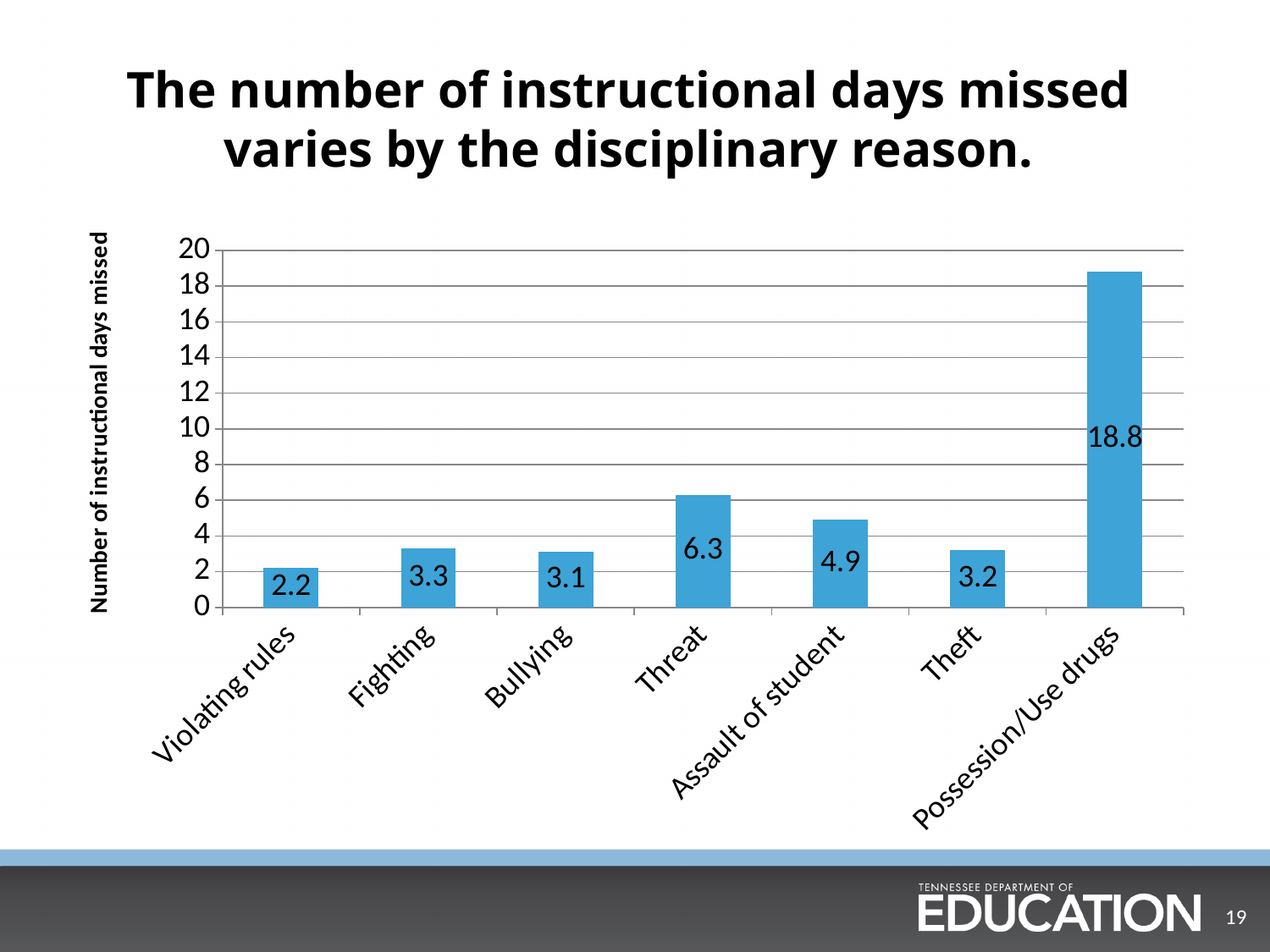
What kind of chart is shown on the slide? Bar chart Which disciplinary reason has the lowest number of instructional days missed? Violating rules What is the number of instructional days missed for Threat? 6.3 What is the number of instructional days missed for Violating rules? 2.2 What is the difference in instructional days missed between Assault of student and Fighting? 1.6 Which disciplinary reason has the highest number of instructional days missed? Possession/Use drugs How many disciplinary reasons are shown on the chart? 7 Is the value for Possession/Use drugs greater or less than 10? greater What is the number of instructional days missed for Possession/Use drugs? 18.8 What is the label of the vertical axis? Number of instructional days missed What is the difference in instructional days missed between Possession/Use drugs and Threat? 12.5 Which has more instructional days missed, Threat or Assault of student? Threat